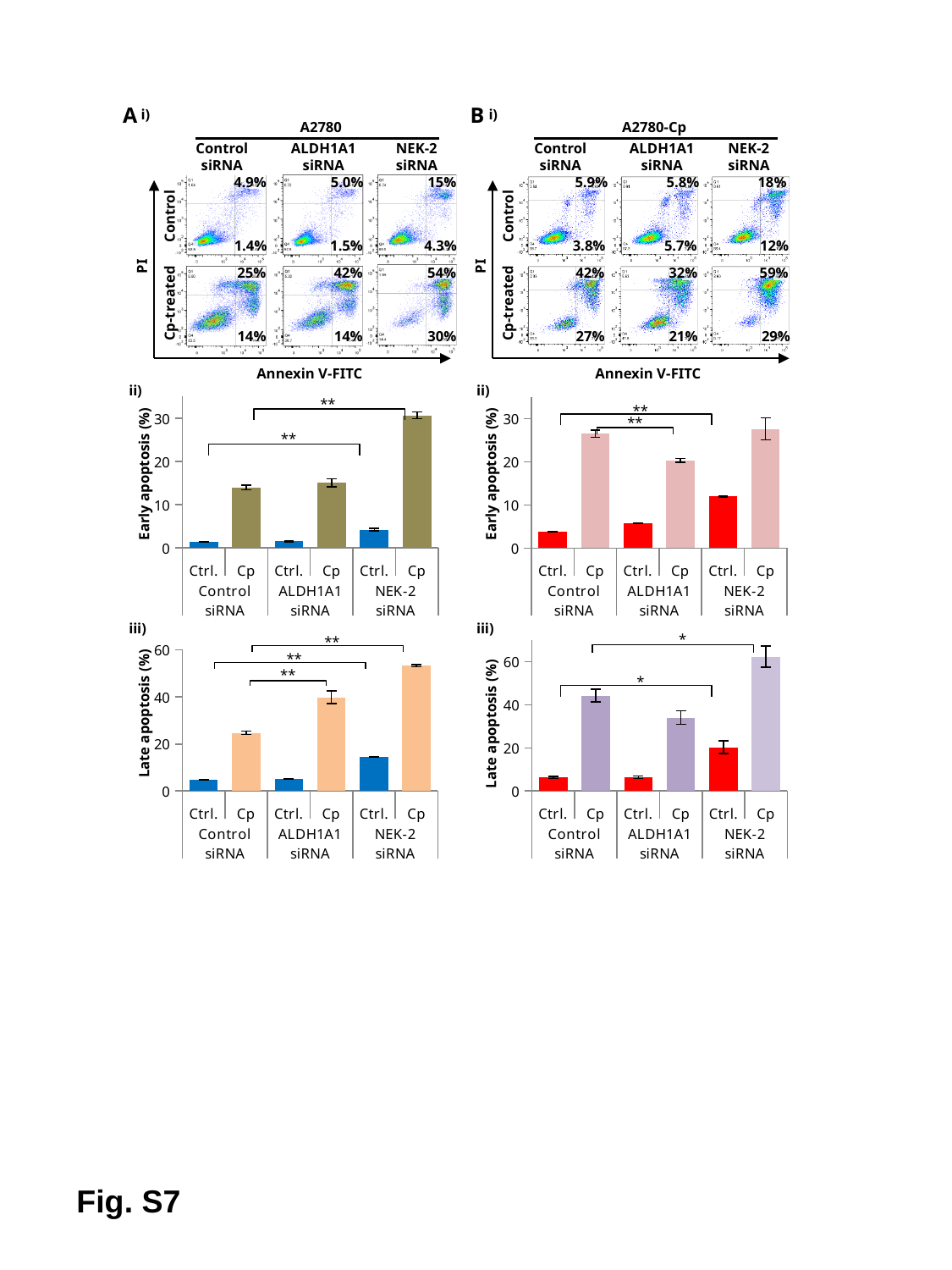
What kind of chart is panel A ii (Early apoptosis, A2780)? bar chart In panel A ii (Early apoptosis, A2780), is the value for NEK-2 siRNA Cp greater or less than 20? greater In panel B iii (Late apoptosis, A2780-Cp), which bar is the highest? NEK-2 siRNA Cp In panel A ii (Early apoptosis, A2780), which bar is the highest? NEK-2 siRNA Cp In panel A iii (Late apoptosis, A2780), which is larger: NEK-2 siRNA Cp or ALDH1A1 siRNA Cp? NEK-2 siRNA Cp In panel A ii (Early apoptosis, A2780), is the value for Control siRNA Cp greater or less than 20? less How many bars are plotted in panel B ii (Early apoptosis, A2780-Cp)? 6 In panel B ii (Early apoptosis, A2780-Cp), which is larger: Control siRNA Cp or ALDH1A1 siRNA Cp? Control siRNA Cp In panel B iii (Late apoptosis, A2780-Cp), is the value for NEK-2 siRNA Ctrl. greater or less than 40? less In the flow cytometry plots of panel B i (A2780-Cp), what percentage is printed in the lower-right quadrant for Control siRNA, Cp-treated? 27% In the flow cytometry plots of panel A i (A2780), what percentage is printed in the upper-right quadrant for NEK-2 siRNA, Cp-treated? 54%